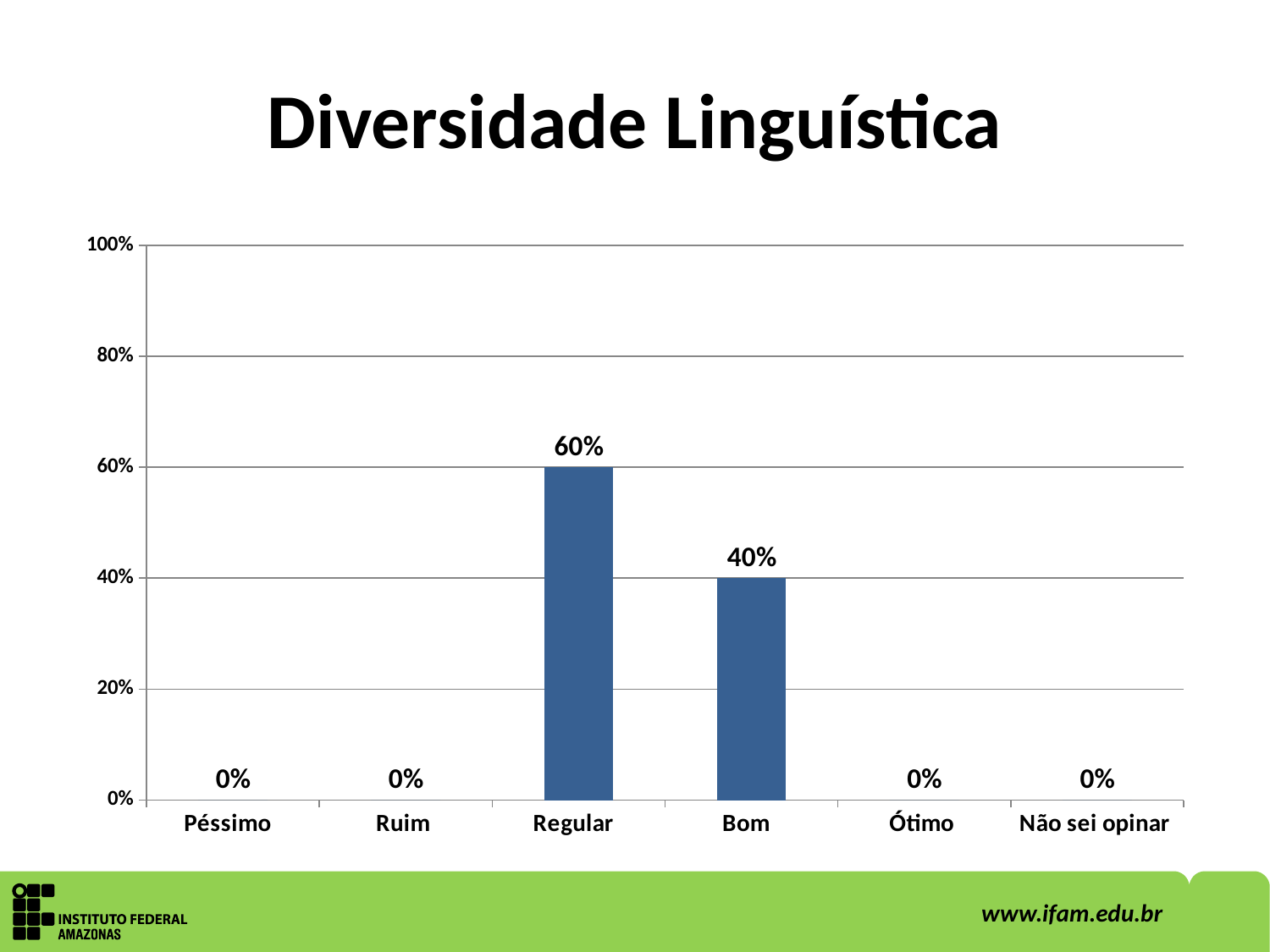
What kind of chart is shown on the slide? bar chart Which category has the highest value? Regular What is the title of the slide? Diversidade Linguística Which is larger, the value for Regular or the value for Bom? Regular What is the value for Bom? 40% What is the value for Péssimo? 0% How many categories have a value of 0%? 4 How many categories are shown on the x axis? 6 What is the difference between the values for Regular and Bom? 20% What is the value for Não sei opinar? 0% Is the value for Bom greater or less than 60%? less What is the value for Regular? 60%